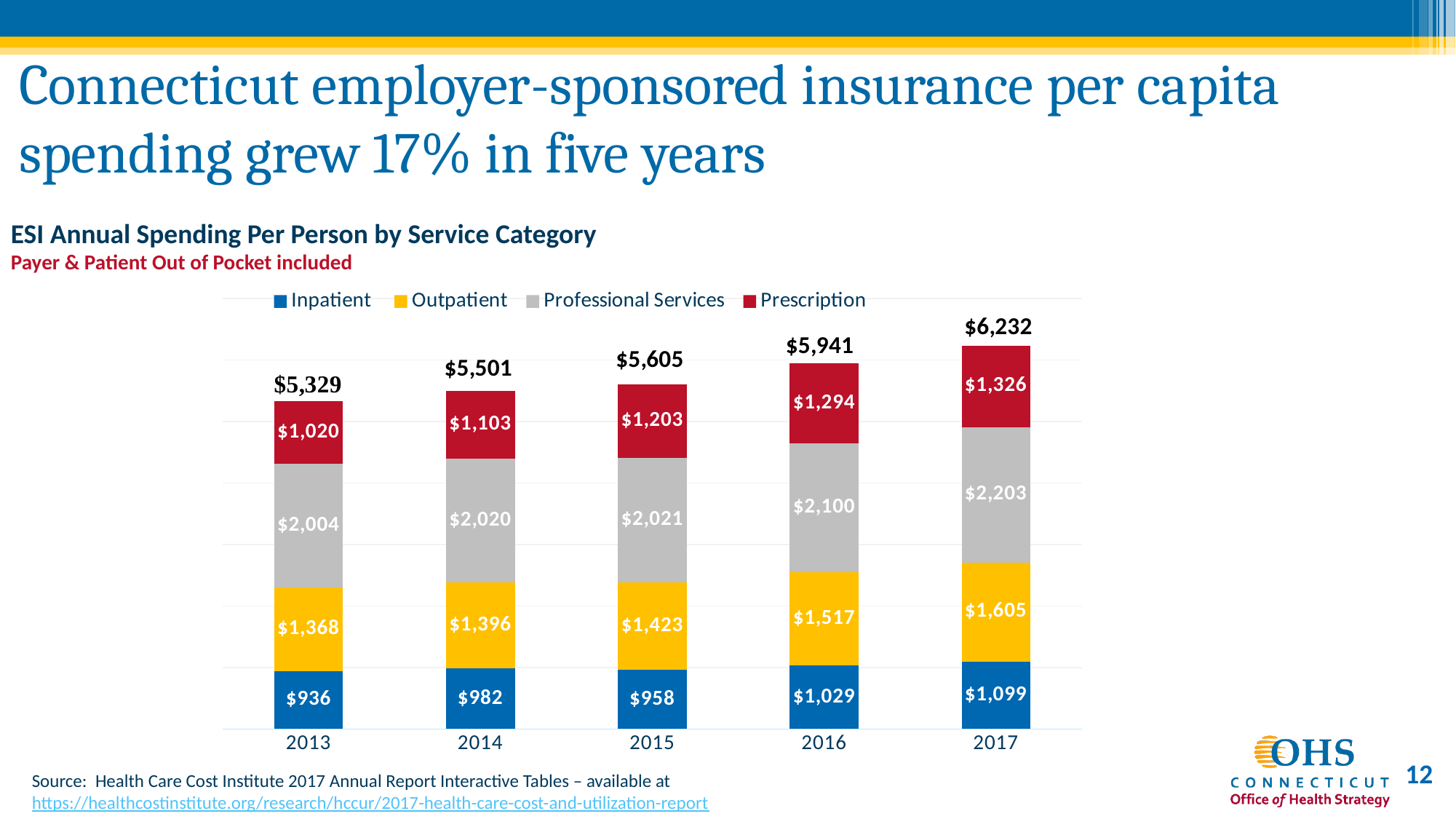
Which is larger: Outpatient spending in 2016 or Professional Services spending in 2013? Professional Services spending in 2013 What is the Prescription spending per person in 2017? $1,326 What is the difference between the total spending per person in 2017 and in 2013? $903 Which year has the highest total spending per person? 2017 How many series does the legend list? 4 What is the Outpatient spending per person in 2015? $1,423 Do the total spending values rise or fall from 2013 to 2017? Rise What is the Inpatient spending per person in 2013? $936 What is the total spending per person shown for 2014? $5,501 Which year has the lowest Inpatient spending per person? 2013 What is the Professional Services spending per person in 2016? $2,100 By how much did Prescription spending per person increase from 2013 to 2017? $306